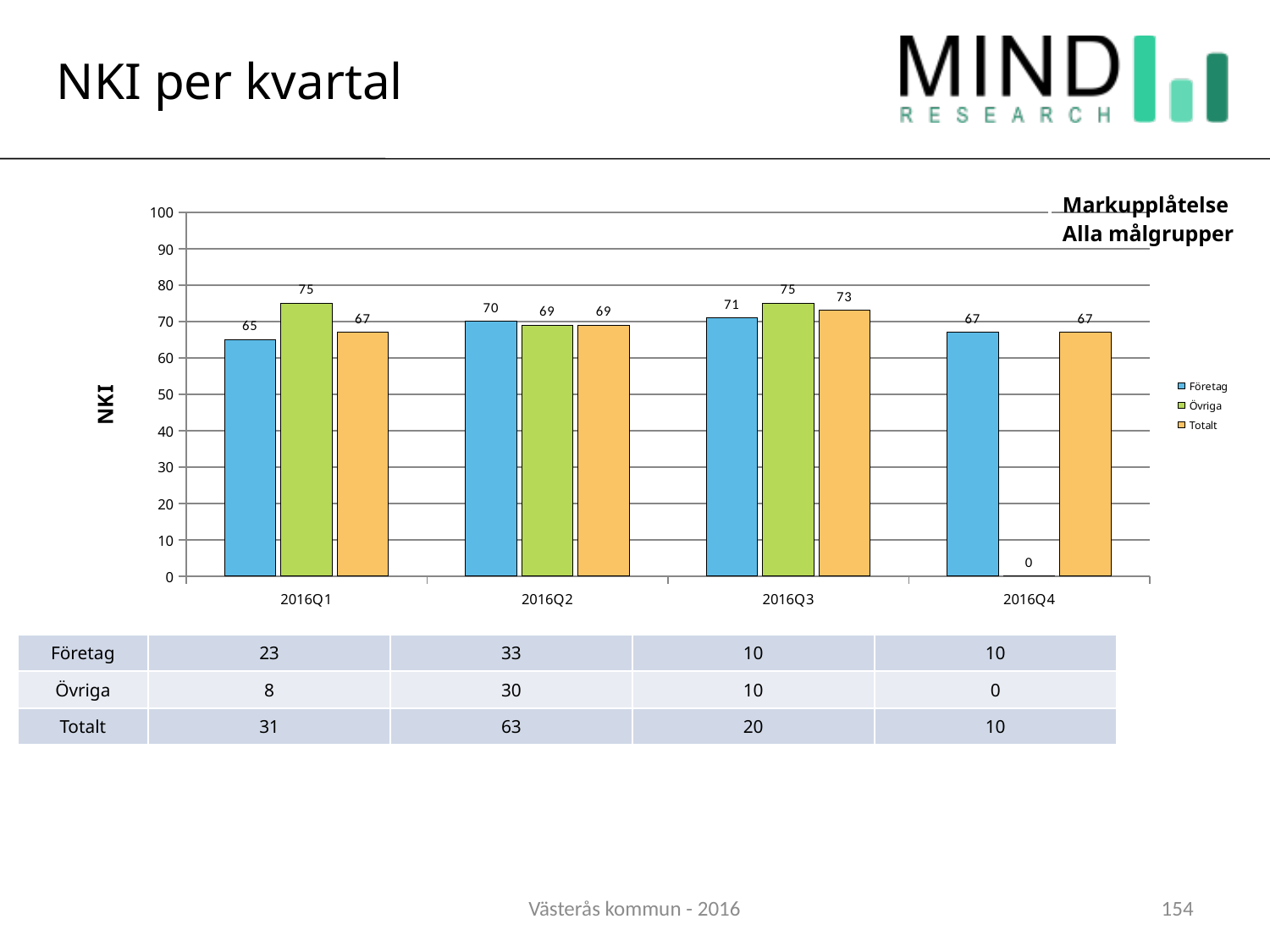
What is the NKI value for Övriga in 2016Q4? 0 In which quarter is the Totalt NKI value highest? 2016Q3 What is the difference between the Övriga and Företag NKI values in 2016Q1? 10 Which is larger in 2016Q3, the Företag value or the Totalt value? Totalt What is the NKI value for Företag in 2016Q1? 65 What is the NKI value for Totalt in 2016Q2? 69 What kind of chart is shown on the slide? Bar chart In which quarter is the Företag NKI value lowest? 2016Q1 How many quarters are shown on the x axis? 4 What is the label on the vertical axis of the chart? NKI How many series does the legend list? 3 What is the NKI value for Övriga in 2016Q3? 75